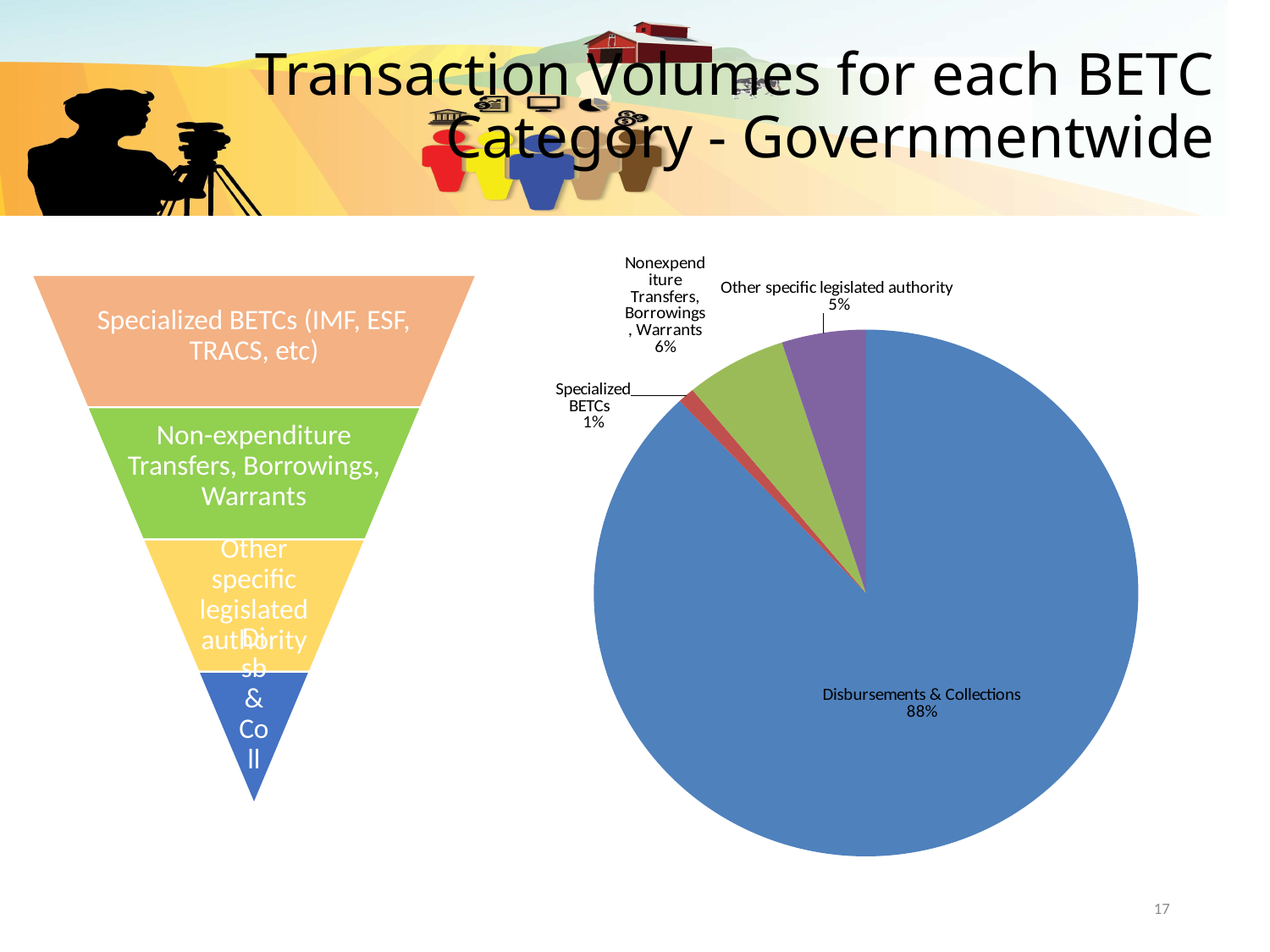
Which category has the smallest slice in the pie chart? Specialized BETCs In the pie chart, what share of transaction volume is Disbursements & Collections? 88% In the pie chart, what share is shown for Other specific legislated authority? 5% In the pie chart, which is larger: Nonexpenditure Transfers, Borrowings, Warrants or Other specific legislated authority? Nonexpenditure Transfers, Borrowings, Warrants How many slices does the pie chart have? 4 What kind of chart is shown on the right side of the slide? pie chart Which category has the largest slice in the pie chart? Disbursements & Collections In the pie chart, what share is shown for Specialized BETCs? 1% In the pie chart, what is the combined share of Specialized BETCs and Other specific legislated authority? 6% In the pie chart, what is the difference in percentage points between Disbursements & Collections and Nonexpenditure Transfers, Borrowings, Warrants? 82 What colour is the Disbursements & Collections slice in the pie chart? blue